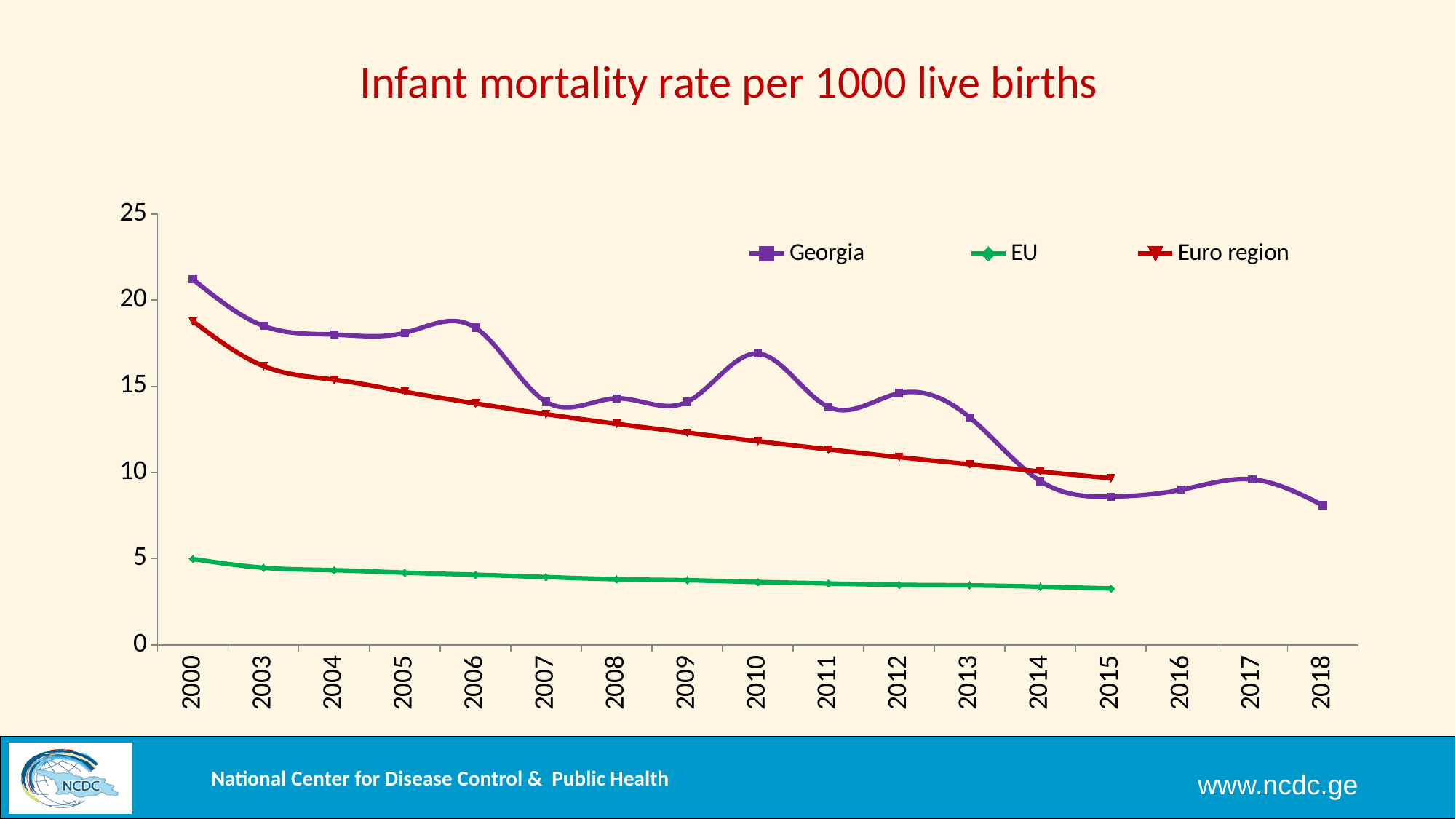
Does the EU series rise or fall from 2000 to 2015? fall Is the value for Georgia in 2018 greater or less than 10? less In which year is the Georgia series at its highest? 2000 Which series has the lowest values across the chart? EU How many years are labelled on the x axis? 17 Is the value for EU in 2015 greater or less than 5? less What is the title of the chart? Infant mortality rate per 1000 live births Which is larger in 2000, the value for Georgia or the value for Euro region? Georgia Which series has the highest value in 2000? Georgia How many series does the legend list? 3 What kind of chart is shown on the slide? line chart Is the value for Georgia in 2000 greater or less than 20? greater